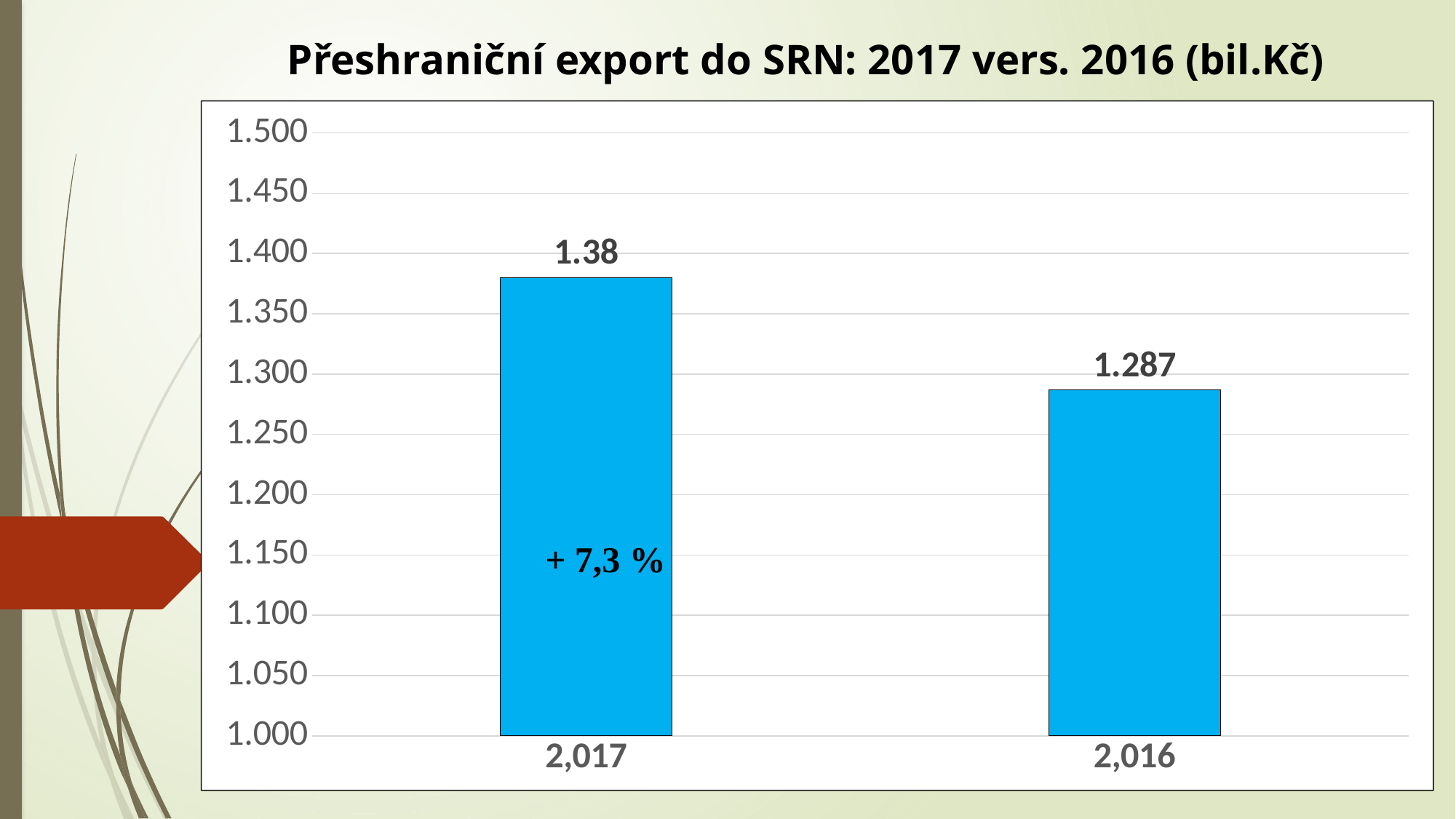
What is the value shown for 2,017? 1.38 What kind of chart is shown on the slide? bar chart Is the value for 2,017 greater or less than 1.350? greater Is the value for 2,016 greater or less than 1.300? less What percentage change is annotated on the 2,017 bar? + 7,3 % Which year has the higher bar? 2,017 Is the value for 2,017 larger or smaller than the value for 2,016? larger What is the difference between the values for 2,017 and 2,016? 0.093 What is the value shown for 2,016? 1.287 Which year has the lower bar? 2,016 What is the title of the chart? Přeshraniční export do SRN: 2017 vers. 2016 (bil.Kč) How many bars are shown in the chart? 2